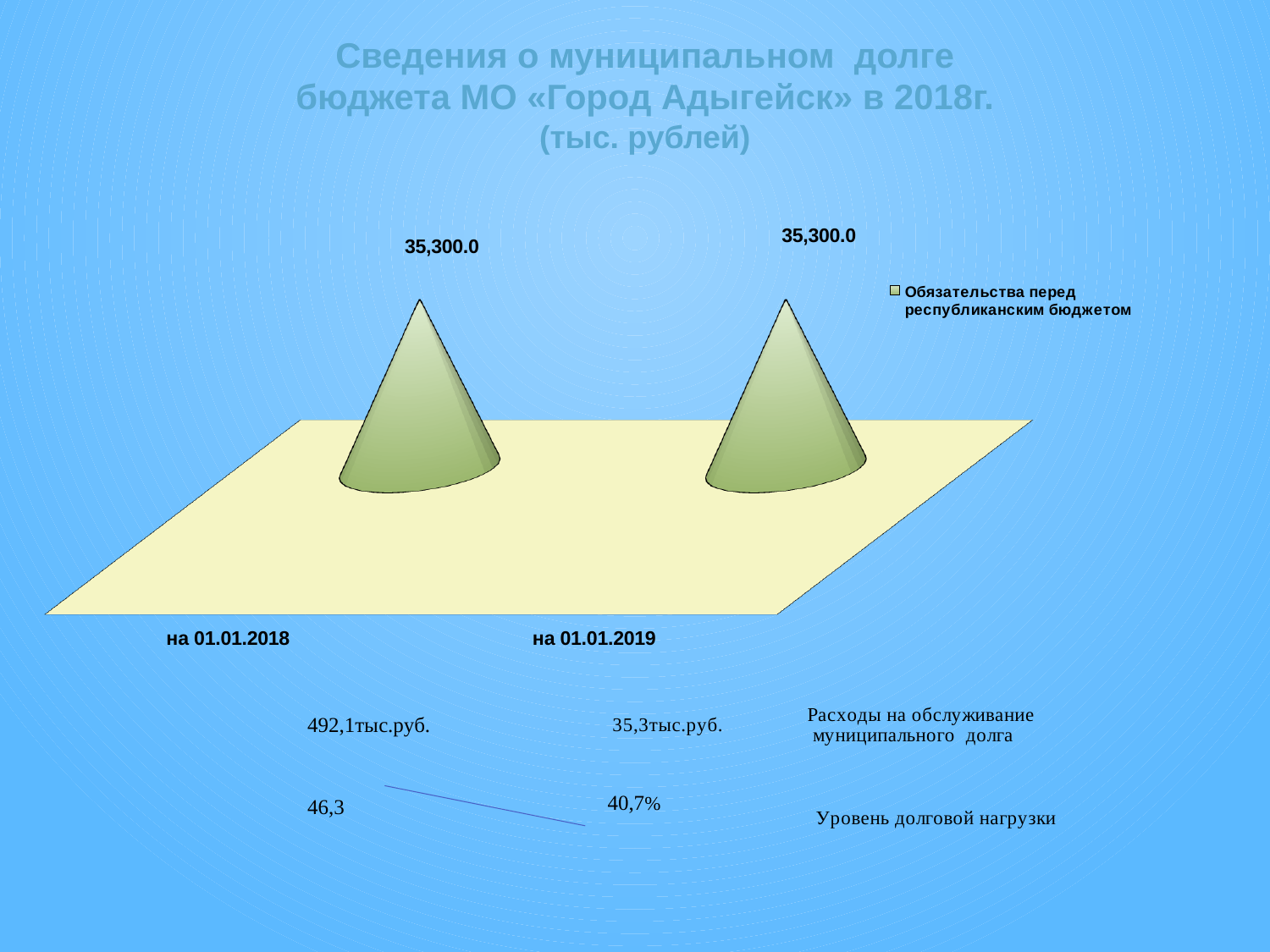
How many series does the chart legend list? 1 What is the value for "на 01.01.2018" in the chart? 35,300.0 What is the difference between the values for "на 01.01.2018" and "на 01.01.2019"? 0.0 Is the value for "на 01.01.2019" larger than, smaller than, or equal to the value for "на 01.01.2018"? equal How many categories are plotted in the chart? 2 What kind of chart is shown on the slide? bar chart What is the value for "на 01.01.2019" in the chart? 35,300.0 In what units are the chart values given, according to the slide title? тыс. рублей What series name is shown in the chart legend? Обязательства перед республиканским бюджетом Does the plotted value rise, fall, or stay the same from "на 01.01.2018" to "на 01.01.2019"? stays the same